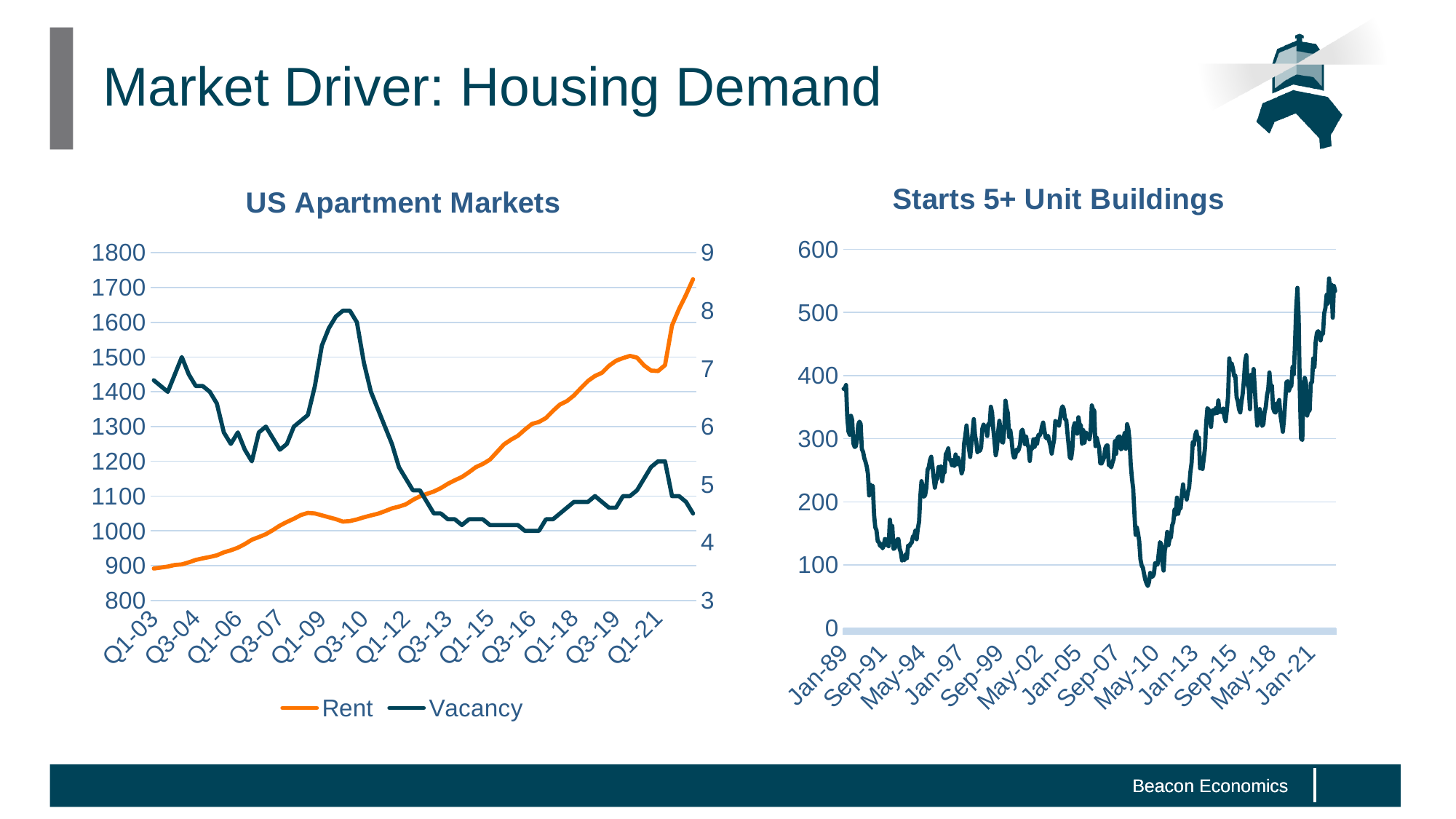
What kind of chart is the 'US Apartment Markets' chart? line chart In the 'US Apartment Markets' chart, does the Rent series generally rise or fall from Q1-03 to Q1-21? rise In the 'US Apartment Markets' chart, is the Rent value at Q1-21 greater or less than 1400? greater In the 'US Apartment Markets' chart, is the Vacancy value at Q3-13 greater or less than 5? less In the 'US Apartment Markets' chart, which series is drawn in orange? Rent How many series does the legend of the 'US Apartment Markets' chart list? 2 In the 'Starts 5+ Unit Buildings' chart, is the value at Jan-89 greater or less than 400? less In the 'Starts 5+ Unit Buildings' chart, does the series generally rise or fall between May-10 and Jan-21? rise What kind of chart is the 'Starts 5+ Unit Buildings' chart? line chart